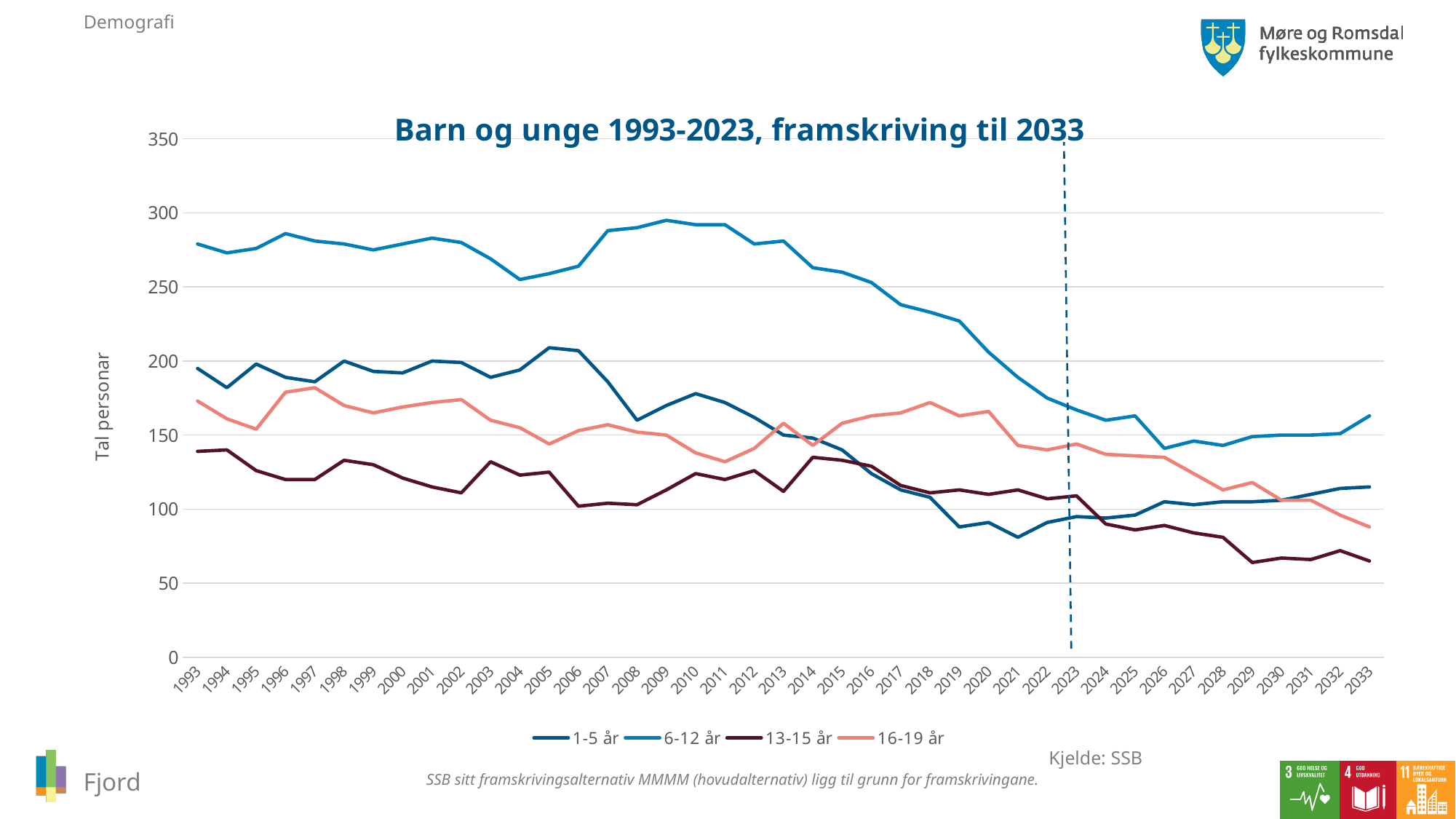
What kind of chart is shown on the slide? line chart How many years are shown along the x axis? 41 Is the value for 1-5 år in 2021 greater or less than 100? less How many series does the legend list? 4 In 2033, which is larger: the value for 1-5 år or the value for 13-15 år? 1-5 år Which series has the highest value in 1993? 6-12 år What is the title of the chart? Barn og unge 1993-2023, framskriving til 2033 Is the value for 6-12 år in 2009 greater or less than 250? greater Does the 6-12 år series rise or fall overall from 1993 to 2033? fall Which series has the lowest value in 1993? 13-15 år Is the value for 13-15 år in 2033 greater or less than 100? less In 2005, which is larger: the value for 1-5 år or the value for 16-19 år? 1-5 år